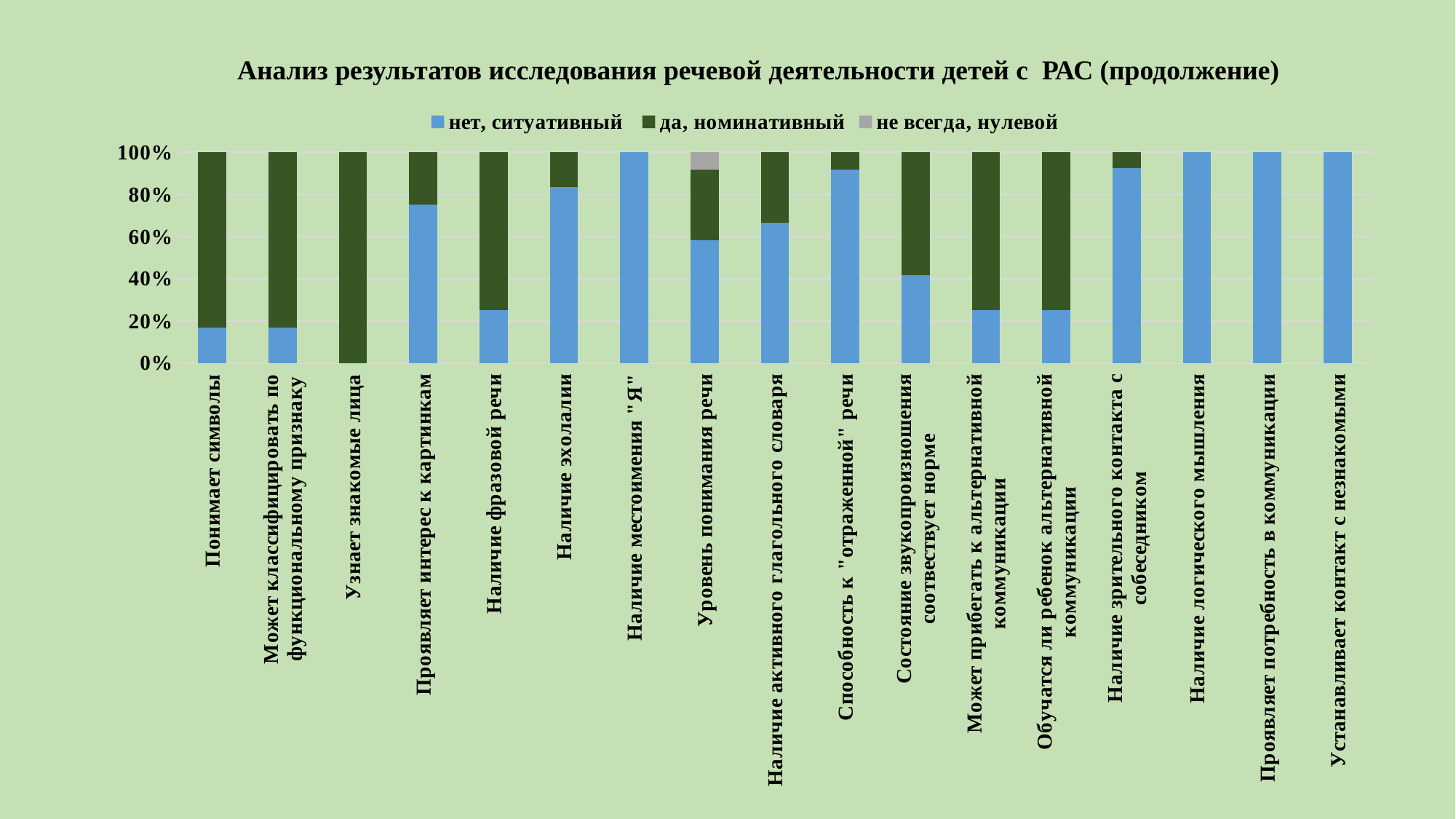
How many categories are shown along the x axis? 17 Is the "нет, ситуативный" value for "Наличие активного глагольного словаря" greater or less than 60%? greater What kind of chart is shown on the slide? stacked bar chart Which category is the only one whose bar is entirely "да, номинативный"? Узнает знакомые лица What is the total height of the stacked bar for "Понимает символы"? 100% How many series does the legend list? 3 Is the "нет, ситуативный" value for "Наличие эхолалии" greater or less than 80%? greater Which is larger for "Наличие фразовой речи": the "нет, ситуативный" segment or the "да, номинативный" segment? да, номинативный Is the "нет, ситуативный" value for "Понимает символы" greater or less than 20%? less Which category is the only one with a "не всегда, нулевой" segment? Уровень понимания речи